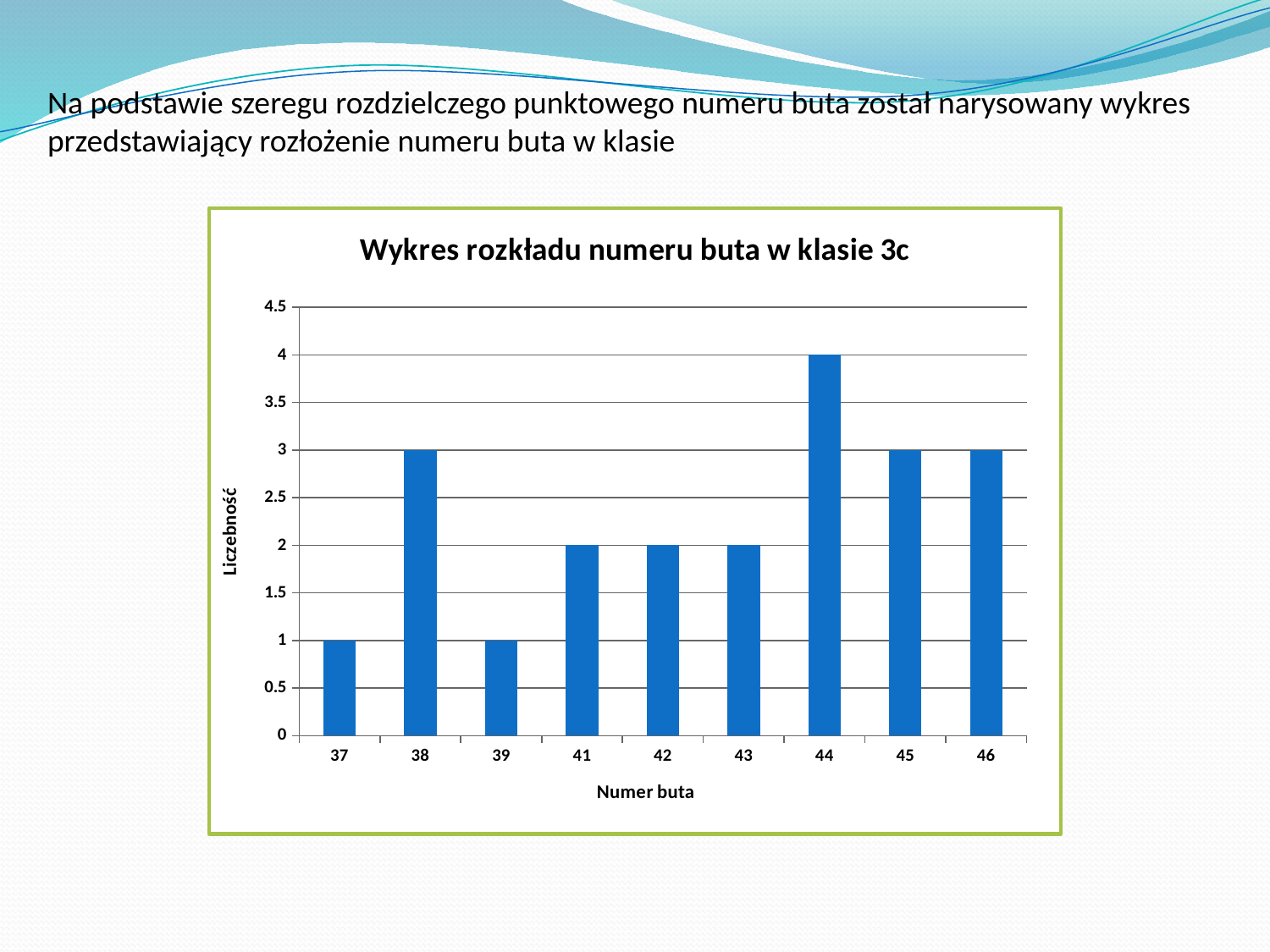
What is the label of the x axis? Numer buta What type of chart is shown on the slide? bar chart Which has a larger count, shoe size 45 or shoe size 43? 45 How many shoe-size categories are shown on the x axis? 9 What is the title of the chart? Wykres rozkładu numeru buta w klasie 3c Which shoe sizes have the lowest count? 37 and 39 Which shoe size has the highest count? 44 What is the value (Liczebność) for shoe size 41? 2 What is the value (Liczebność) for shoe size 38? 3 What is the value (Liczebność) for shoe size 44? 4 Is the value for shoe size 44 greater or less than 3.5? greater What is the difference between the counts for shoe size 44 and shoe size 37? 3